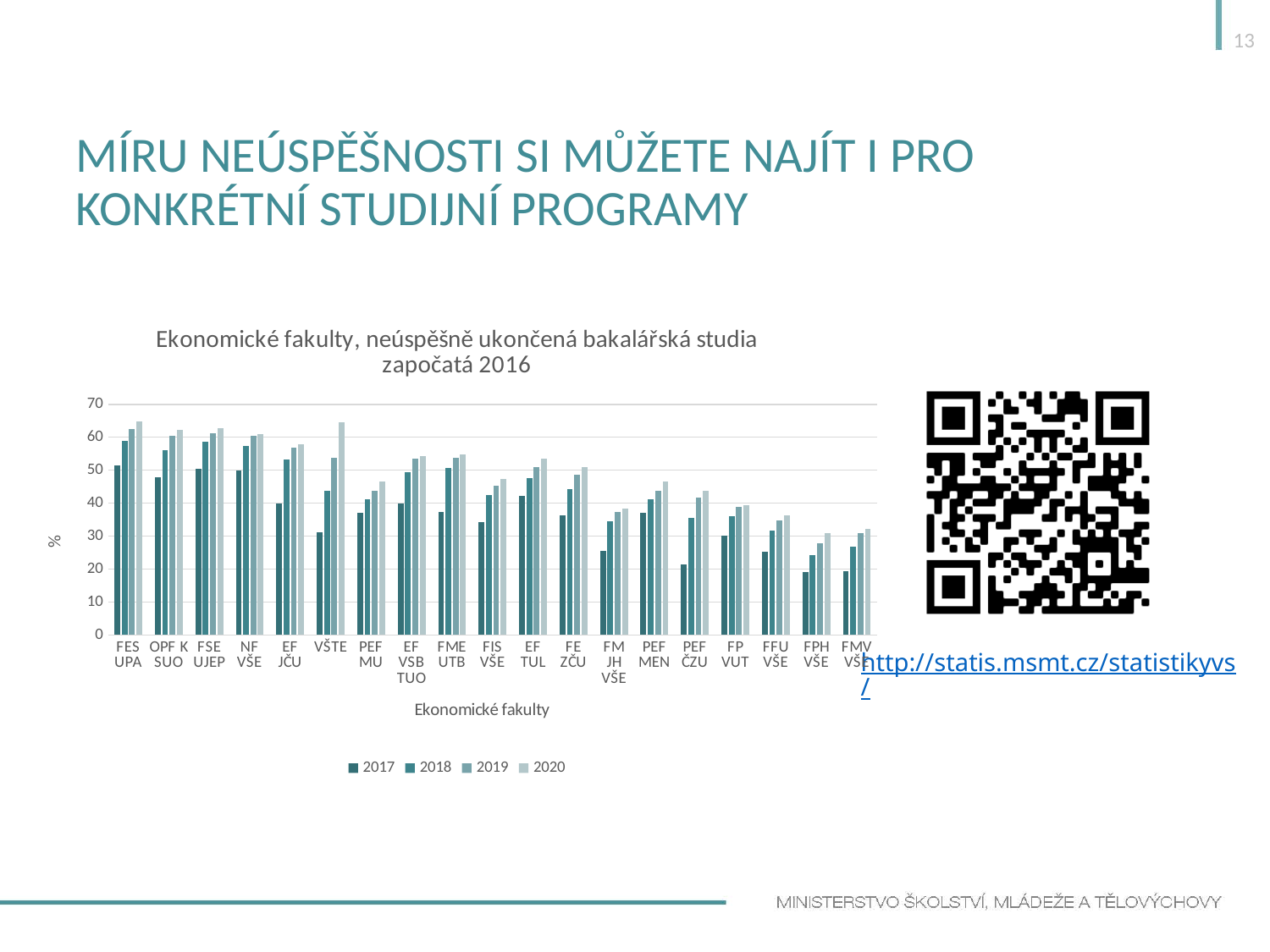
What is the title of the chart? Ekonomické fakulty, neúspěšně ukončená bakalářská studia započatá 2016 Which is larger, the 2020 value for FES UPA or the 2020 value for FPH VŠE? FES UPA Is the 2020 value for FFU VŠE greater or less than 30? greater What kind of chart is shown on the slide? bar chart For PEF ČZU, which year has the lowest value? 2017 How many faculties (categories) are shown on the x axis? 19 Is the 2017 value for FM JH VŠE greater or less than 30? less For VŠTE, which year has the highest value? 2020 Is the 2020 value for VŠTE greater or less than 60? greater How many series does the legend list? 4 What is the label of the y axis? %